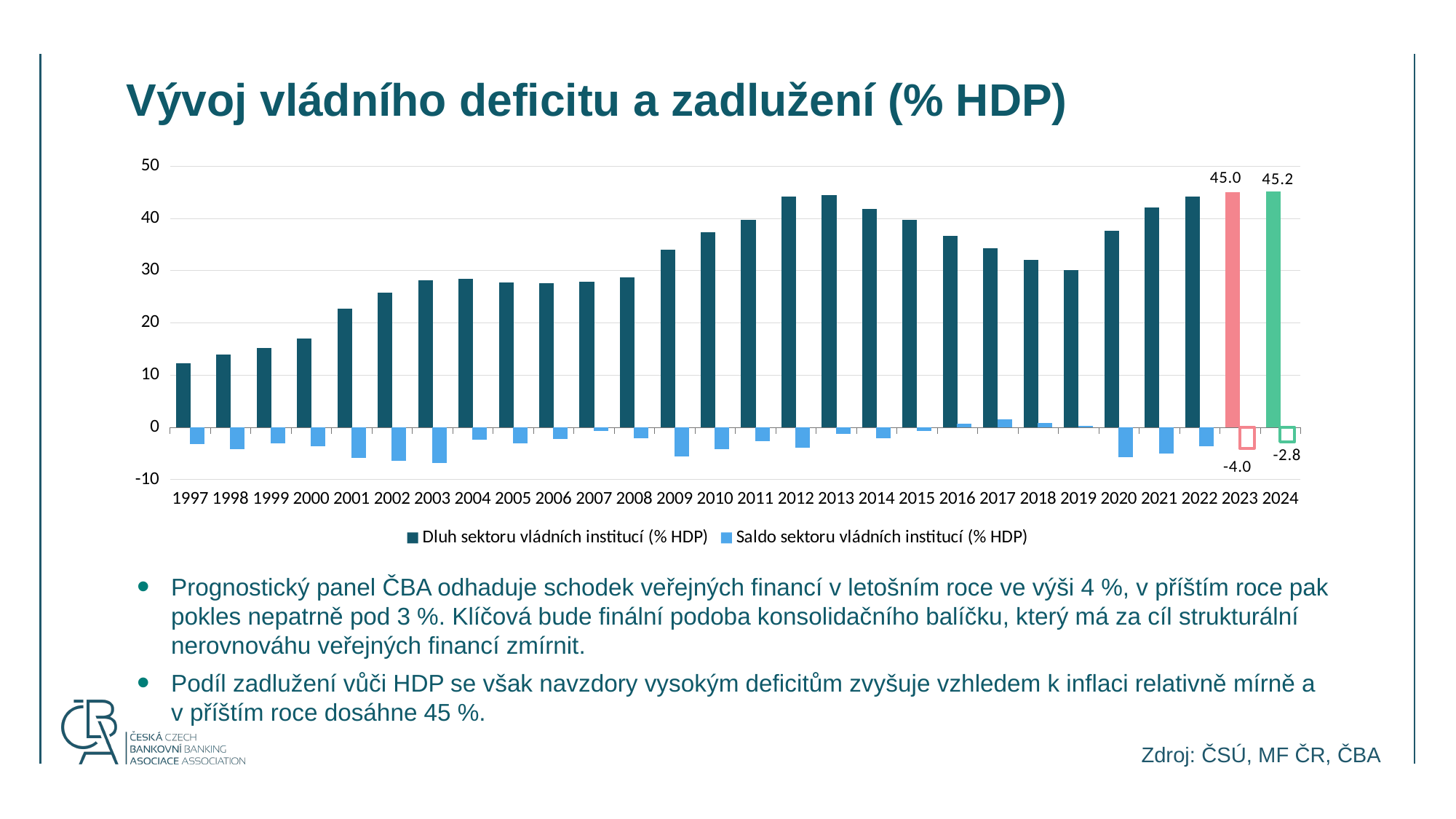
Is the Dluh sektoru vládních institucí value for 1997 greater or less than 20? less By how much does the Dluh sektoru vládních institucí value for 2024 exceed the value for 2023? 0.2 What is the title of the chart on the slide? Vývoj vládního deficitu a zadlužení (% HDP) What is the value of Saldo sektoru vládních institucí (% HDP) for 2023? -4.0 How many years are shown on the x axis of the chart? 28 Which year has the larger Saldo sektoru vládních institucí value, 2023 or 2024? 2024 What is the value of Dluh sektoru vládních institucí (% HDP) for 2024? 45.2 Which year has the lowest Dluh sektoru vládních institucí (% HDP) value? 1997 What is the value of Saldo sektoru vládních institucí (% HDP) for 2024? -2.8 What kind of chart is shown on the slide? Bar chart What is the value of Dluh sektoru vládních institucí (% HDP) for 2023? 45.0 How many series does the legend list? 2